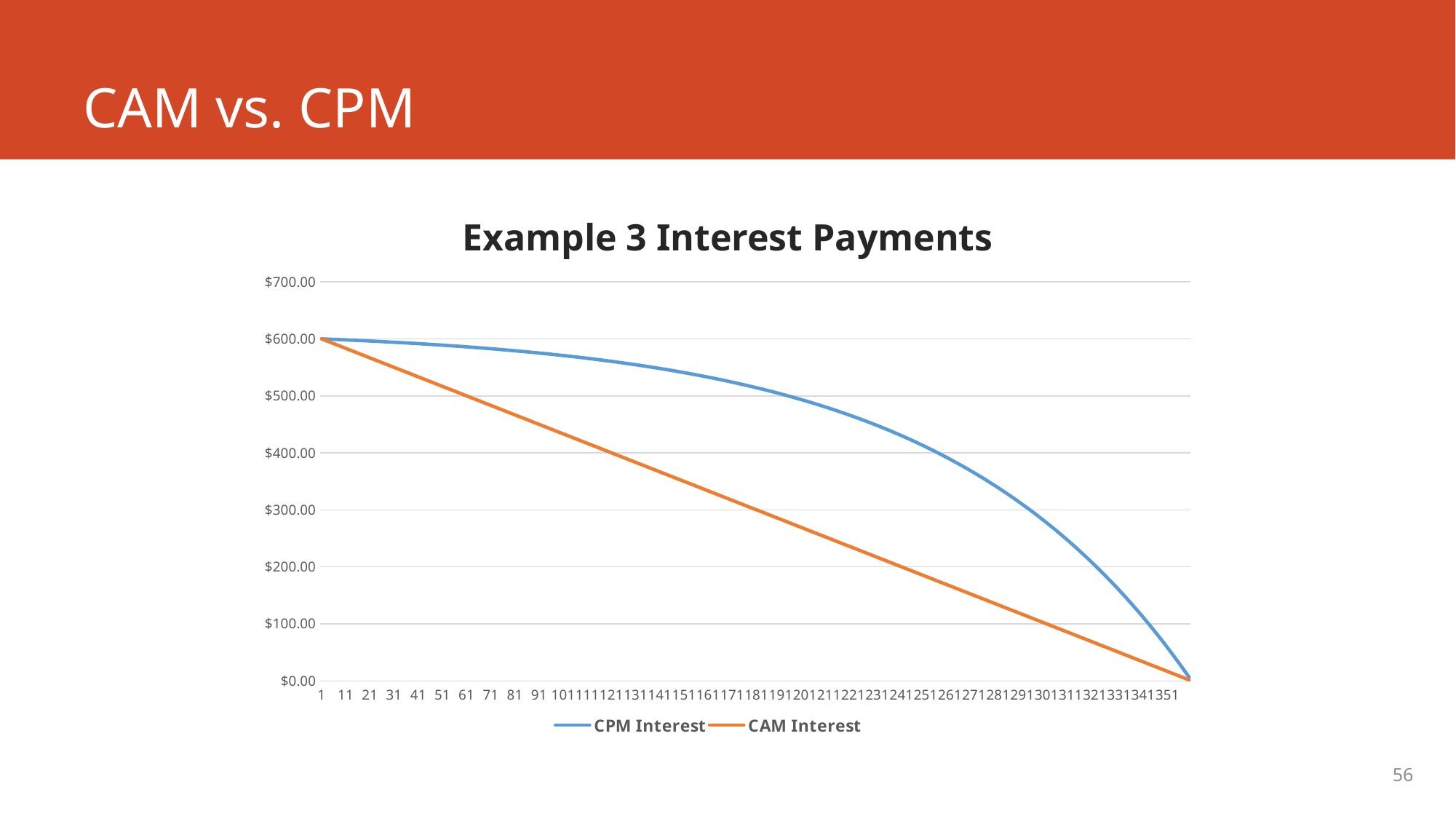
Do the CPM Interest values rise or fall as the period number increases? Fall How many series does the legend list? 2 What is the title of the chart? Example 3 Interest Payments Which series is drawn in orange? CAM Interest What is the value of CPM Interest at period 1? $600.00 What is the value of CAM Interest at period 1? $600.00 What type of chart is shown on the slide? Line chart At period 181, which series has the larger value, CPM Interest or CAM Interest? CPM Interest Is the value for CAM Interest at period 181 greater or less than $400.00? less Do the CAM Interest values rise or fall along the x axis? Fall Is the value for CPM Interest at period 101 greater or less than $500.00? greater Is the value for CAM Interest at period 101 greater or less than $500.00? less